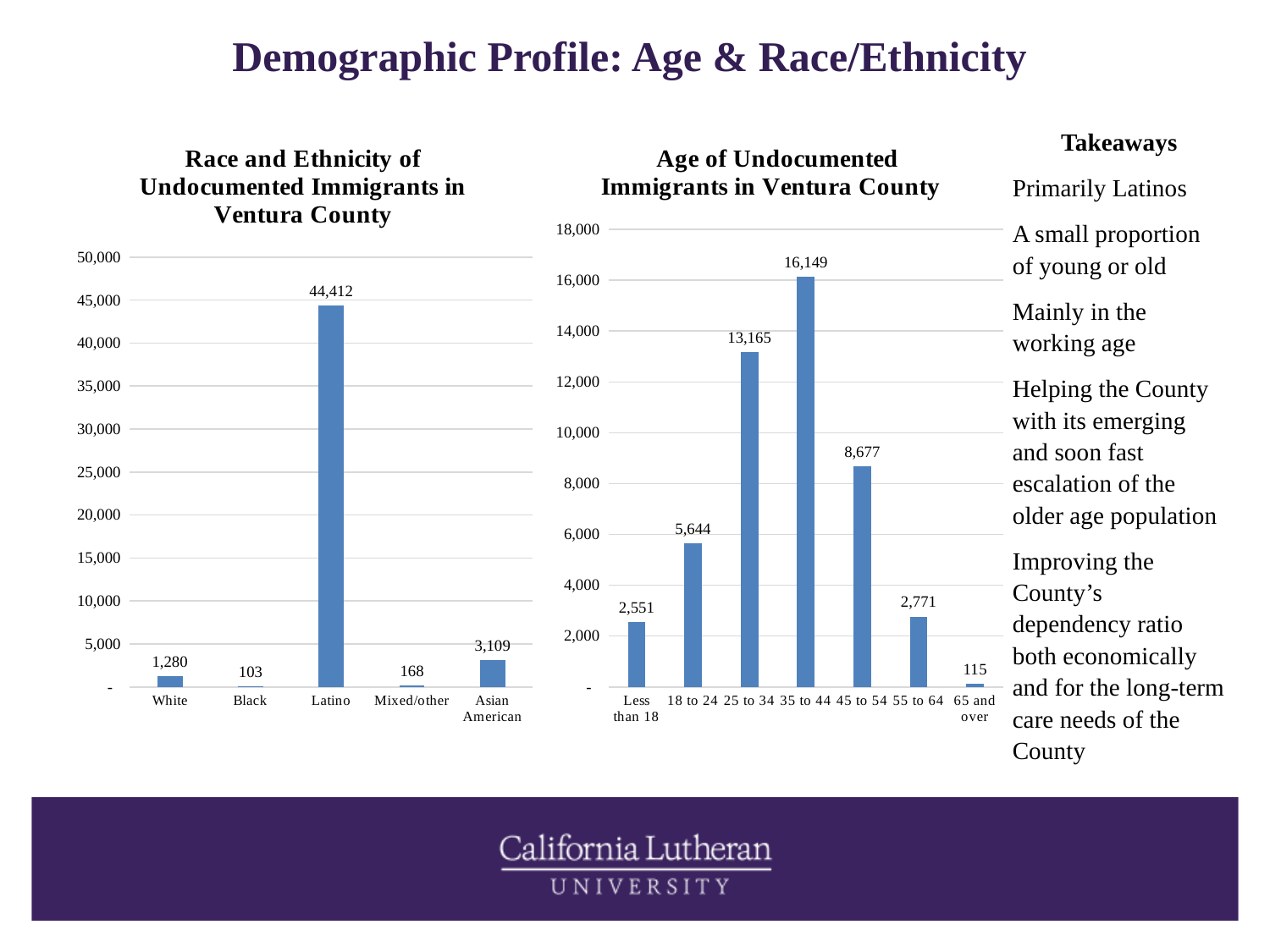
In the 'Race and Ethnicity of Undocumented Immigrants in Ventura County' chart, how many categories are shown on the x axis? 5 In the 'Race and Ethnicity of Undocumented Immigrants in Ventura County' chart, what is the value for Asian American? 3,109 In the 'Age of Undocumented Immigrants in Ventura County' chart, what is the value for 65 and over? 115 In the 'Age of Undocumented Immigrants in Ventura County' chart, which is larger, the value for 18 to 24 or the value for 55 to 64? 18 to 24 In the 'Race and Ethnicity of Undocumented Immigrants in Ventura County' chart, what is the difference between the values for White and Mixed/other? 1,112 In the 'Age of Undocumented Immigrants in Ventura County' chart, what is the value for 25 to 34? 13,165 In the 'Race and Ethnicity of Undocumented Immigrants in Ventura County' chart, which category has the lowest value? Black In the 'Age of Undocumented Immigrants in Ventura County' chart, what is the difference between the values for 35 to 44 and 45 to 54? 7,472 In the 'Age of Undocumented Immigrants in Ventura County' chart, which age group has the highest value? 35 to 44 What type of chart is the 'Age of Undocumented Immigrants in Ventura County' chart? Bar chart In the 'Race and Ethnicity of Undocumented Immigrants in Ventura County' chart, what is the value for Latino? 44,412 In the 'Age of Undocumented Immigrants in Ventura County' chart, how many age groups are shown on the x axis? 7